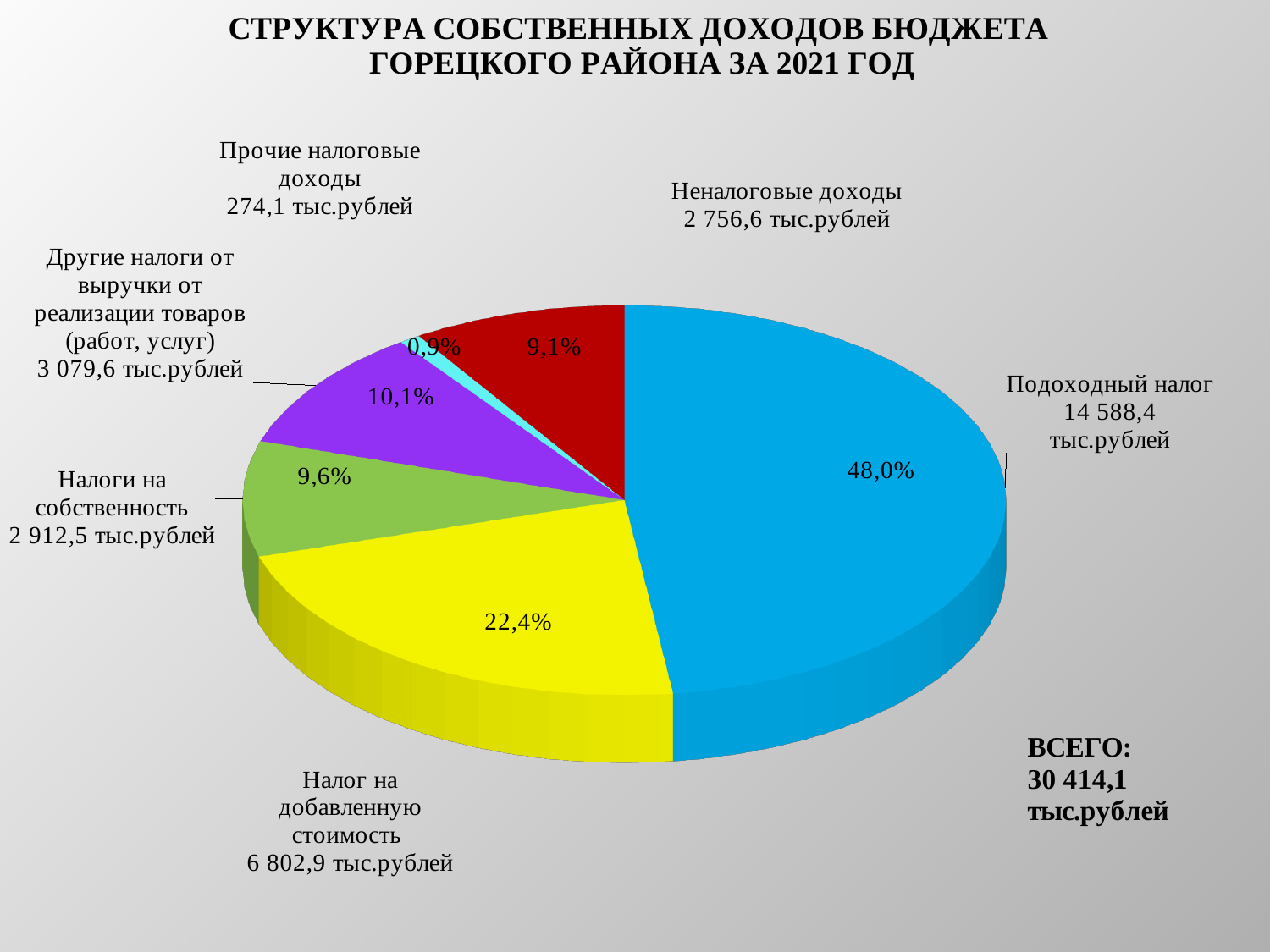
What is the value shown for Неналоговые доходы? 2 756,6 тыс.рублей Which is larger: Налоги на собственность or Другие налоги от выручки от реализации товаров (работ, услуг)? Другие налоги от выручки от реализации товаров (работ, услуг) What is the value shown for Налог на добавленную стоимость? 6 802,9 тыс.рублей What type of chart is shown on the slide? Pie chart Which category has the largest share of the pie? Подоходный налог How many slices does the pie chart have? 6 What percentage share is shown for Налог на добавленную стоимость? 22,4% What is the difference between the values for Подоходный налог and Налог на добавленную стоимость? 7 785,5 тыс.рублей What share of the pie does Подоходный налог represent? 48,0% What total (ВСЕГО) is shown on the slide? 30 414,1 тыс.рублей What is the value shown for Подоходный налог? 14 588,4 тыс.рублей Which category has the smallest share of the pie? Прочие налоговые доходы